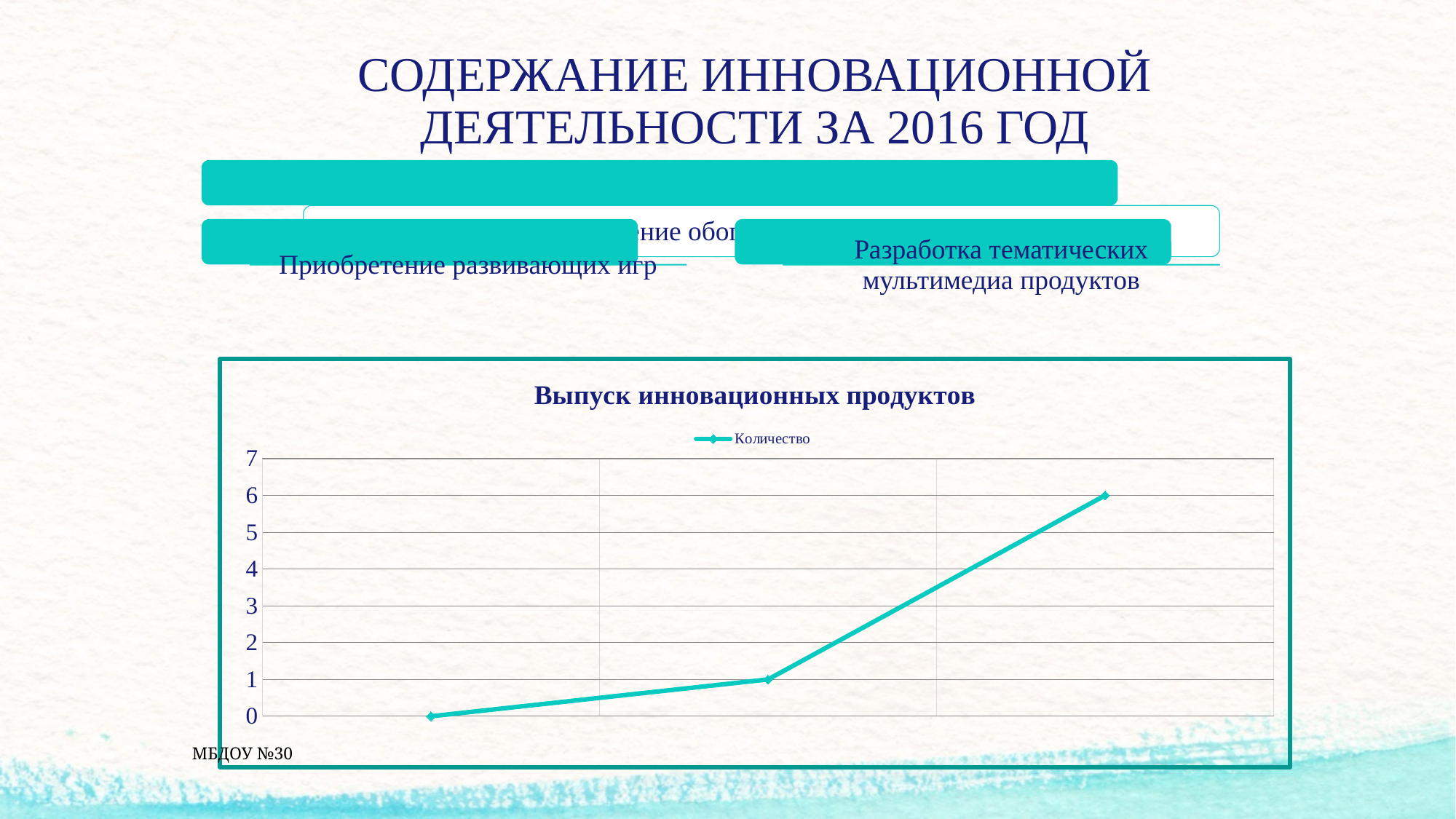
What is the title of the chart? Выпуск инновационных продуктов How many series does the chart legend list? 1 What kind of chart is shown on the slide? line chart What is the name of the series shown in the legend? Количество What is the value of the first (leftmost) point on the line? 0 What is the value of the middle point on the line? 1 What is the value of the last (rightmost) point on the line? 6 Do the values rise or fall from left to right along the x axis? rise How many data points are plotted on the line? 3 What is the highest value plotted on the chart? 6 Is the value of the rightmost point greater or less than 5? greater What is the difference between the last point and the first point on the line? 6